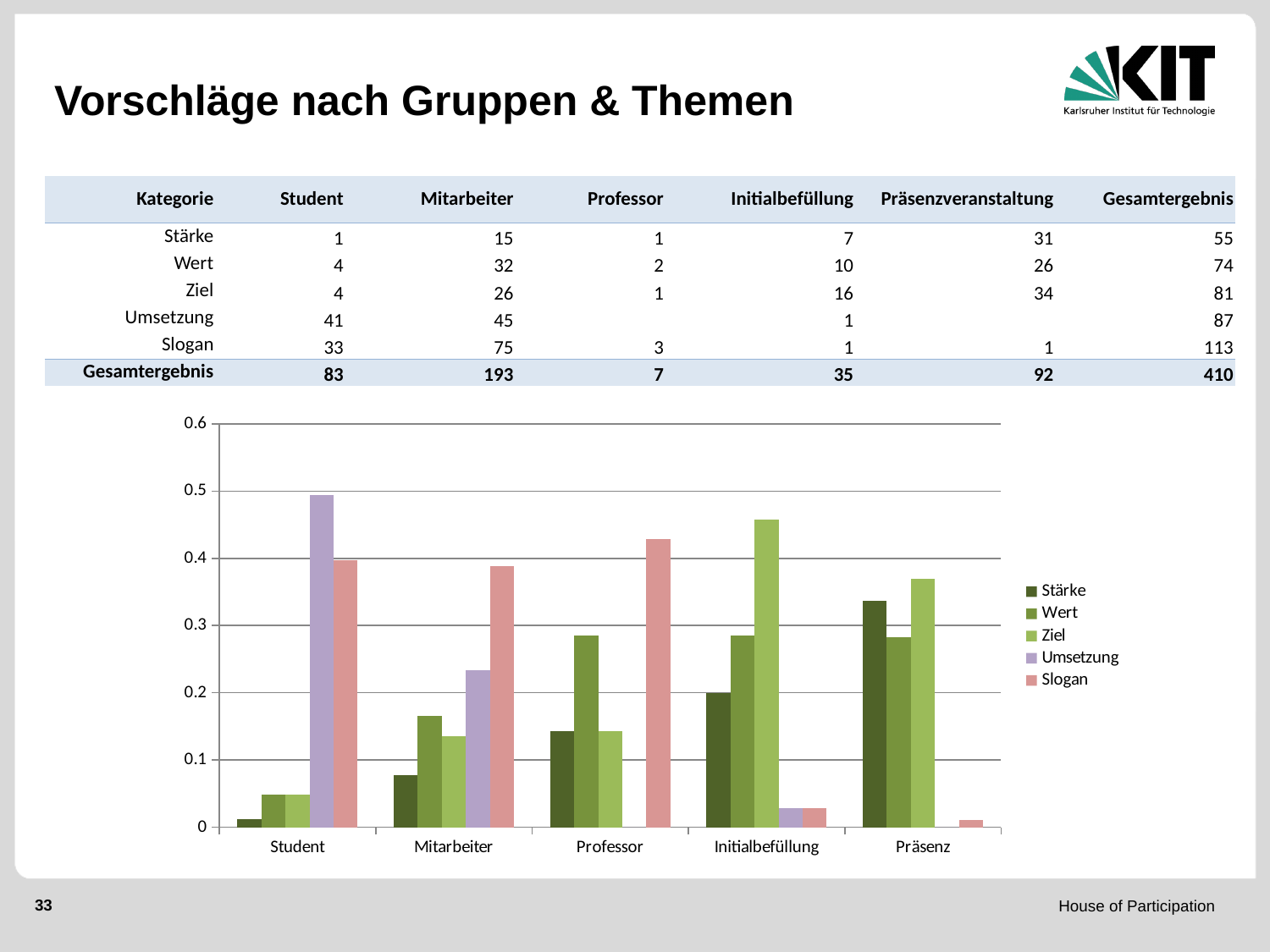
Is the value for Umsetzung in the Student group greater or less than 0.4? greater Which series has the highest bar in the Student group? Umsetzung Which series has the highest bar in the Professor group? Slogan Which is larger: the Stärke bar for Präsenz or the Stärke bar for Initialbefüllung? Präsenz Which series has the lowest bar in the Student group? Stärke What kind of chart is shown on the slide? bar chart How many series does the chart legend list? 5 What is the highest value shown on the y axis of the chart? 0.6 Is the value for Wert in the Mitarbeiter group greater or less than 0.2? less Do the Stärke bars rise or fall from Student to Präsenz along the x axis? rise How many categories are shown along the x axis of the chart? 5 Which series has the highest bar in the Initialbefüllung group? Ziel